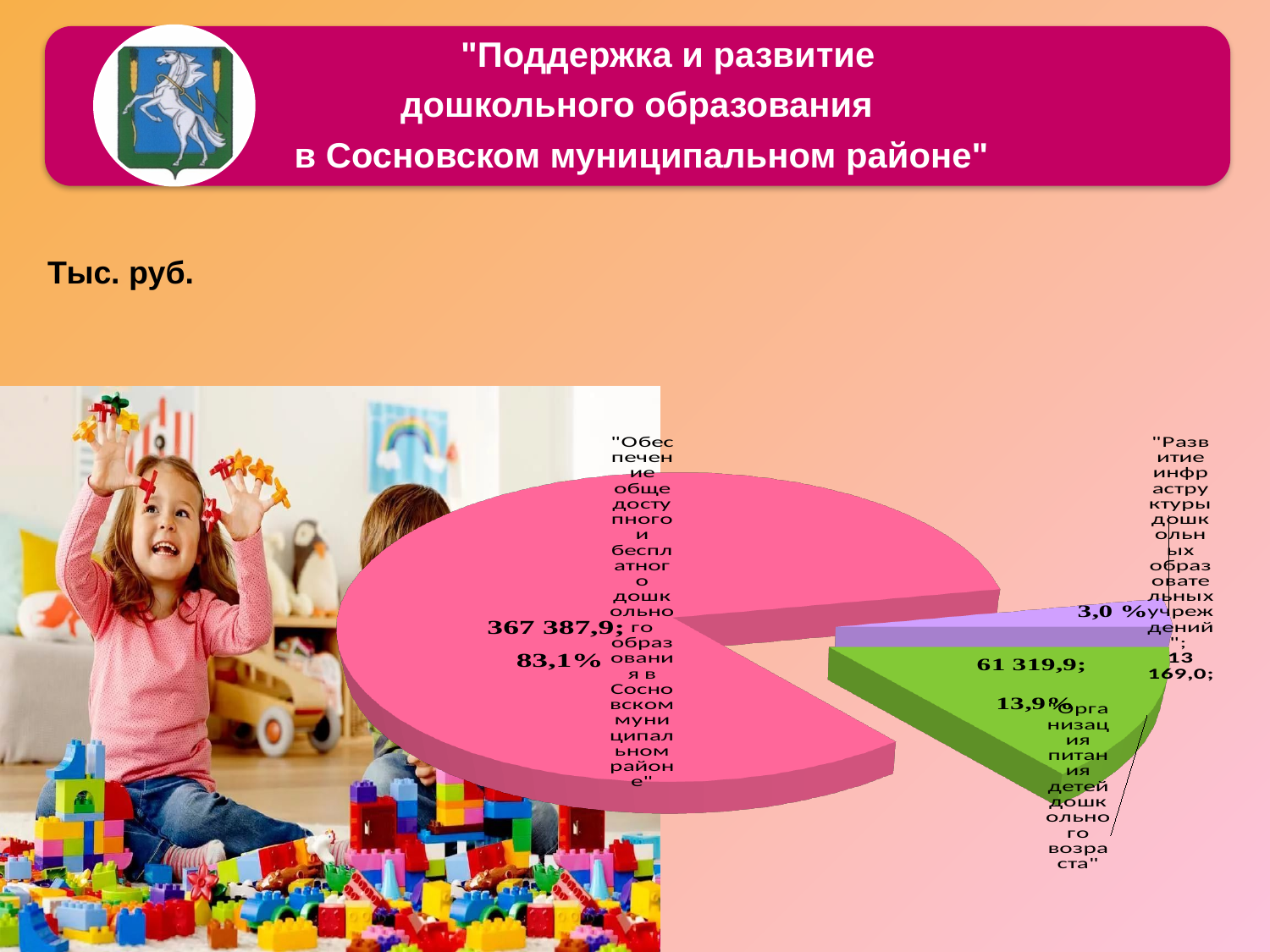
What is the value for "Обеспечение общедоступного и бесплатного дошкольного образования в Сосновском муниципальном районе"? 367 387,9 What share of the pie does "Организация питания детей дошкольного возраста" take? 13,9% What kind of chart is shown on the slide? pie chart Which is larger: the value for "Организация питания детей дошкольного возраста" or for "Развитие инфраструктуры дошкольных образовательных учреждений"? "Организация питания детей дошкольного возраста" What share of the pie does "Развитие инфраструктуры дошкольных образовательных учреждений" take? 3,0 % What is the value for "Организация питания детей дошкольного возраста"? 61 319,9 Which slice of the pie chart is the largest? "Обеспечение общедоступного и бесплатного дошкольного образования в Сосновском муниципальном районе" In what units are the values of the pie chart given, according to the label above the chart? Тыс. руб. What share of the pie does "Обеспечение общедоступного и бесплатного дошкольного образования в Сосновском муниципальном районе" take? 83,1% How many slices does the pie chart have? 3 Which slice of the pie chart is the smallest? "Развитие инфраструктуры дошкольных образовательных учреждений" What is the value for "Развитие инфраструктуры дошкольных образовательных учреждений"? 13 169,0